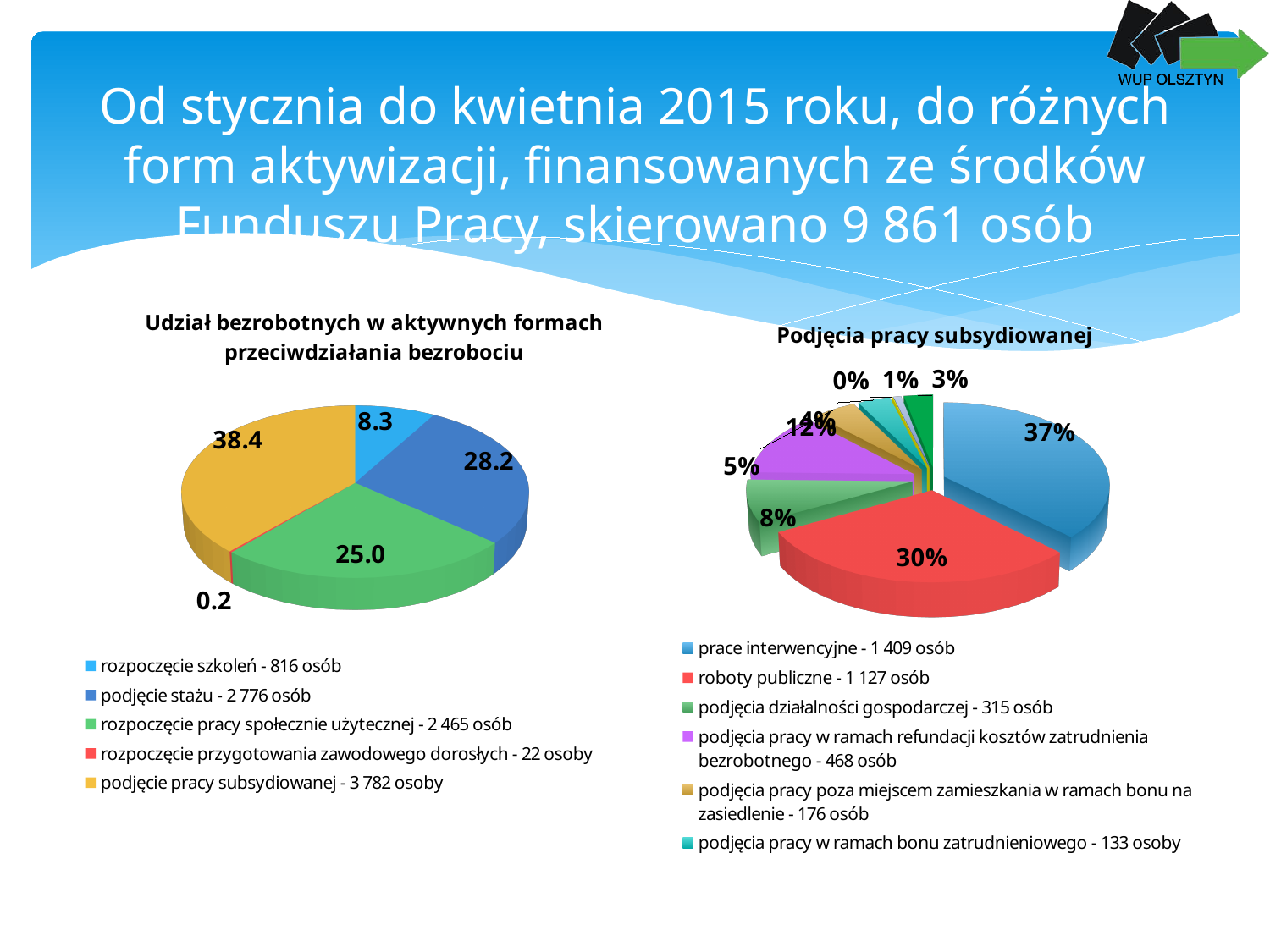
What type of chart is used for 'Udział bezrobotnych w aktywnych formach przeciwdziałania bezrobociu'? pie chart In the chart 'Udział bezrobotnych w aktywnych formach przeciwdziałania bezrobociu', what is the difference between the values for 'podjęcie pracy subsydiowanej' and 'rozpoczęcie szkoleń'? 30.1 In the chart 'Udział bezrobotnych w aktywnych formach przeciwdziałania bezrobociu', what value is shown for 'podjęcie stażu'? 28.2 In the chart 'Podjęcia pracy subsydiowanej', which category has the largest slice? prace interwencyjne In the chart 'Podjęcia pracy subsydiowanej', what share of the pie is 'prace interwencyjne'? 37% In the chart 'Udział bezrobotnych w aktywnych formach przeciwdziałania bezrobociu', which category has the largest slice? podjęcie pracy subsydiowanej In the chart 'Udział bezrobotnych w aktywnych formach przeciwdziałania bezrobociu', which category has the smallest slice? rozpoczęcie przygotowania zawodowego dorosłych How many entries does the legend of the chart 'Podjęcia pracy subsydiowanej' list? 6 How many entries does the legend of the chart 'Udział bezrobotnych w aktywnych formach przeciwdziałania bezrobociu' list? 5 In the chart 'Podjęcia pracy subsydiowanej', which is larger: 'podjęcia działalności gospodarczej' or 'podjęcia pracy w ramach refundacji kosztów zatrudnienia bezrobotnego'? podjęcia pracy w ramach refundacji kosztów zatrudnienia bezrobotnego In the chart 'Podjęcia pracy subsydiowanej', what share of the pie is 'roboty publiczne'? 30% In the chart 'Udział bezrobotnych w aktywnych formach przeciwdziałania bezrobociu', what value is shown for 'rozpoczęcie szkoleń'? 8.3